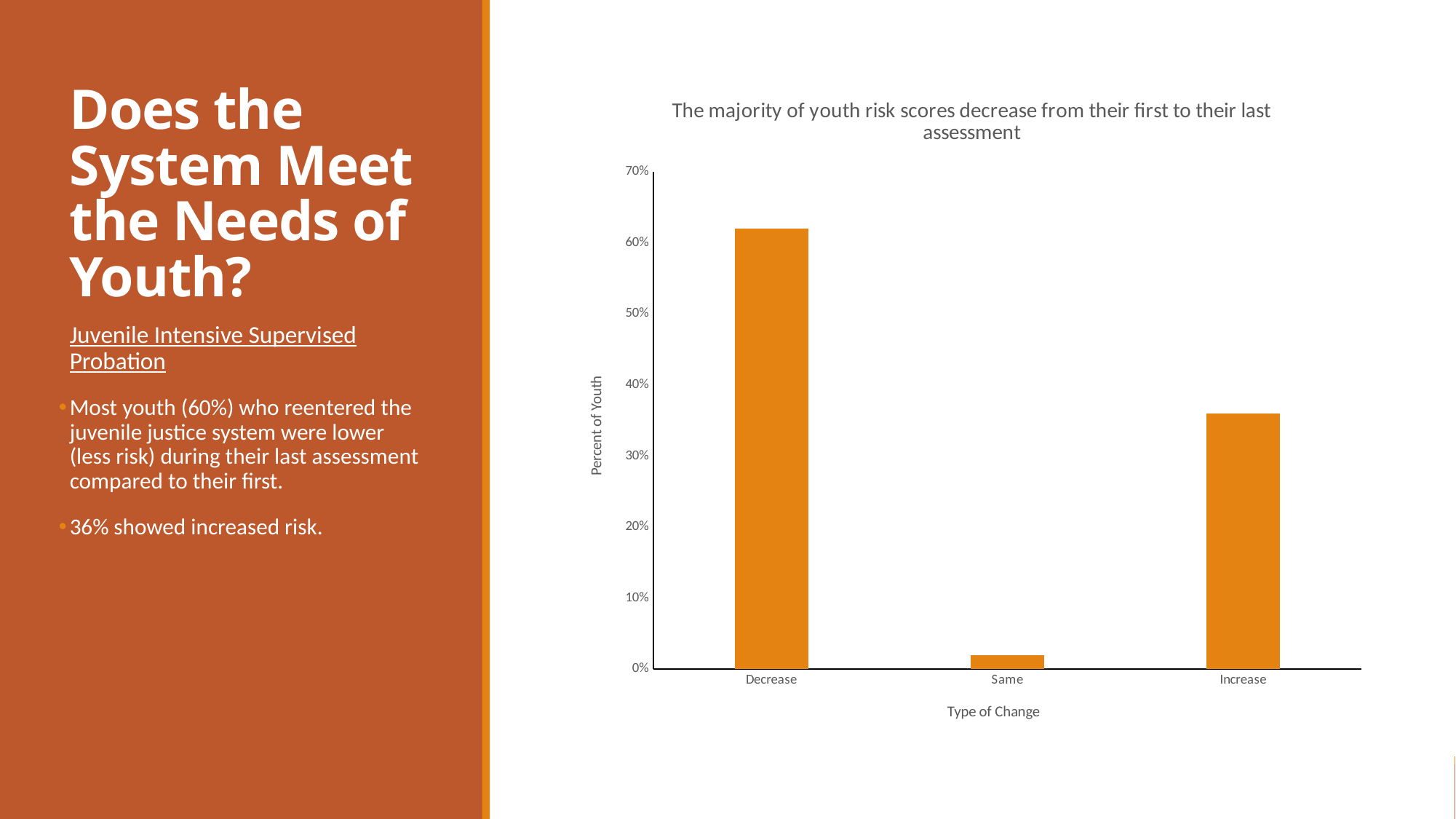
What is the title of the chart? The majority of youth risk scores decrease from their first to their last assessment Is the value for Increase greater or less than 40%? less Is the value for Decrease greater or less than 60%? greater Is the value for Same greater or less than 10%? less Which is larger, the value for Decrease or the value for Increase? Decrease What type of chart is shown on the slide? bar chart Which is larger, the value for Same or the value for Increase? Increase How many categories are shown on the x axis of the chart? 3 Which type of change has the highest percent of youth? Decrease Which type of change has the lowest percent of youth? Same What is the label of the x axis of the chart? Type of Change